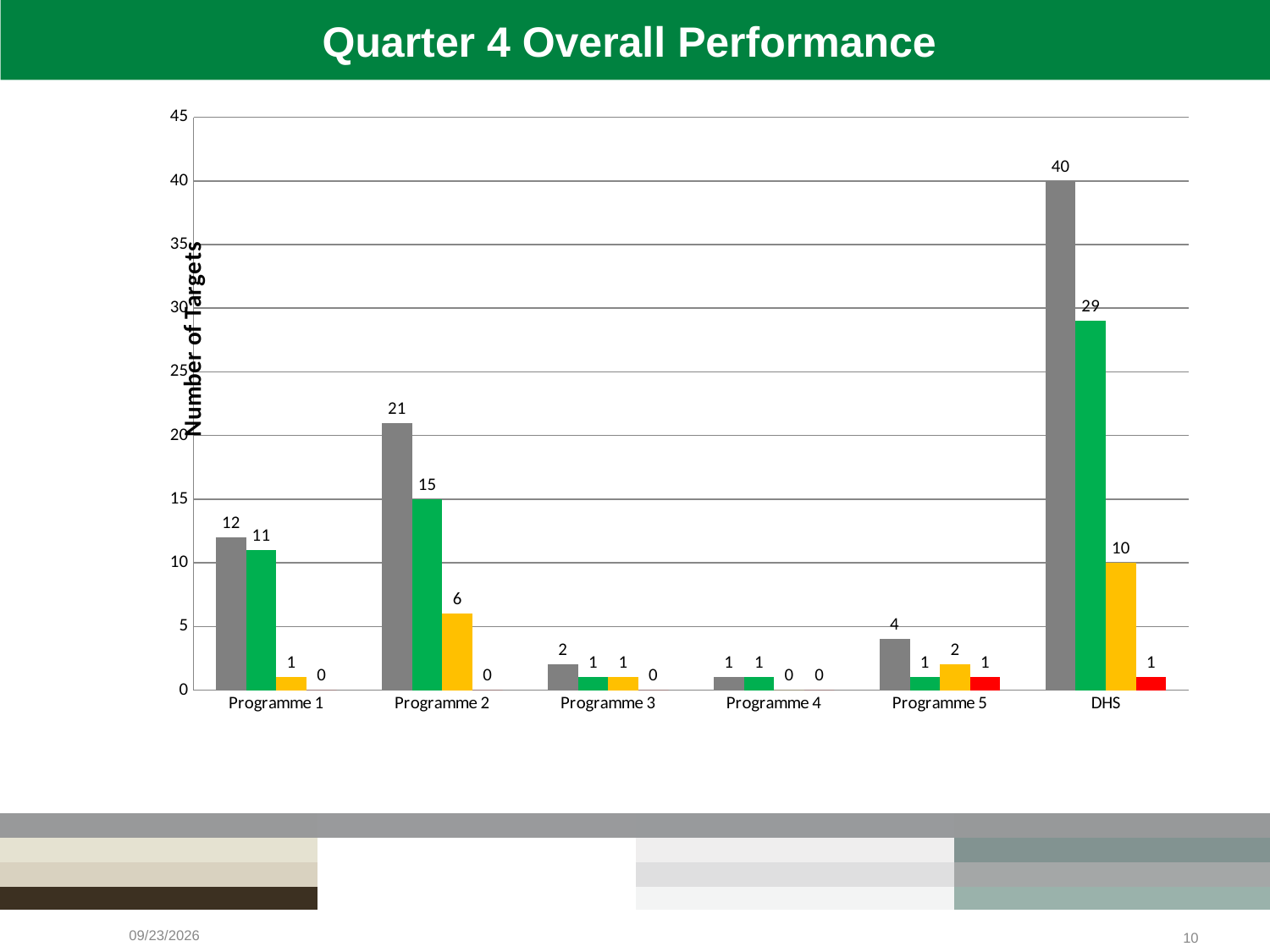
What is the difference between the grey bar and the green bar for DHS? 11 What is the value of the grey bar for DHS? 40 What is the difference between the grey bar for Programme 2 and the grey bar for Programme 1? 9 What is the value of the yellow bar for Programme 1? 1 Which category has the lowest grey bar? Programme 4 What is the value of the yellow bar for DHS? 10 Which is larger, the green bar for Programme 1 or the green bar for Programme 2? Programme 2 What is the label of the y axis? Number of Targets What type of chart is shown on the slide? bar chart Which category has the highest grey bar? DHS What is the value of the green bar for Programme 2? 15 How many categories are shown on the x axis? 6